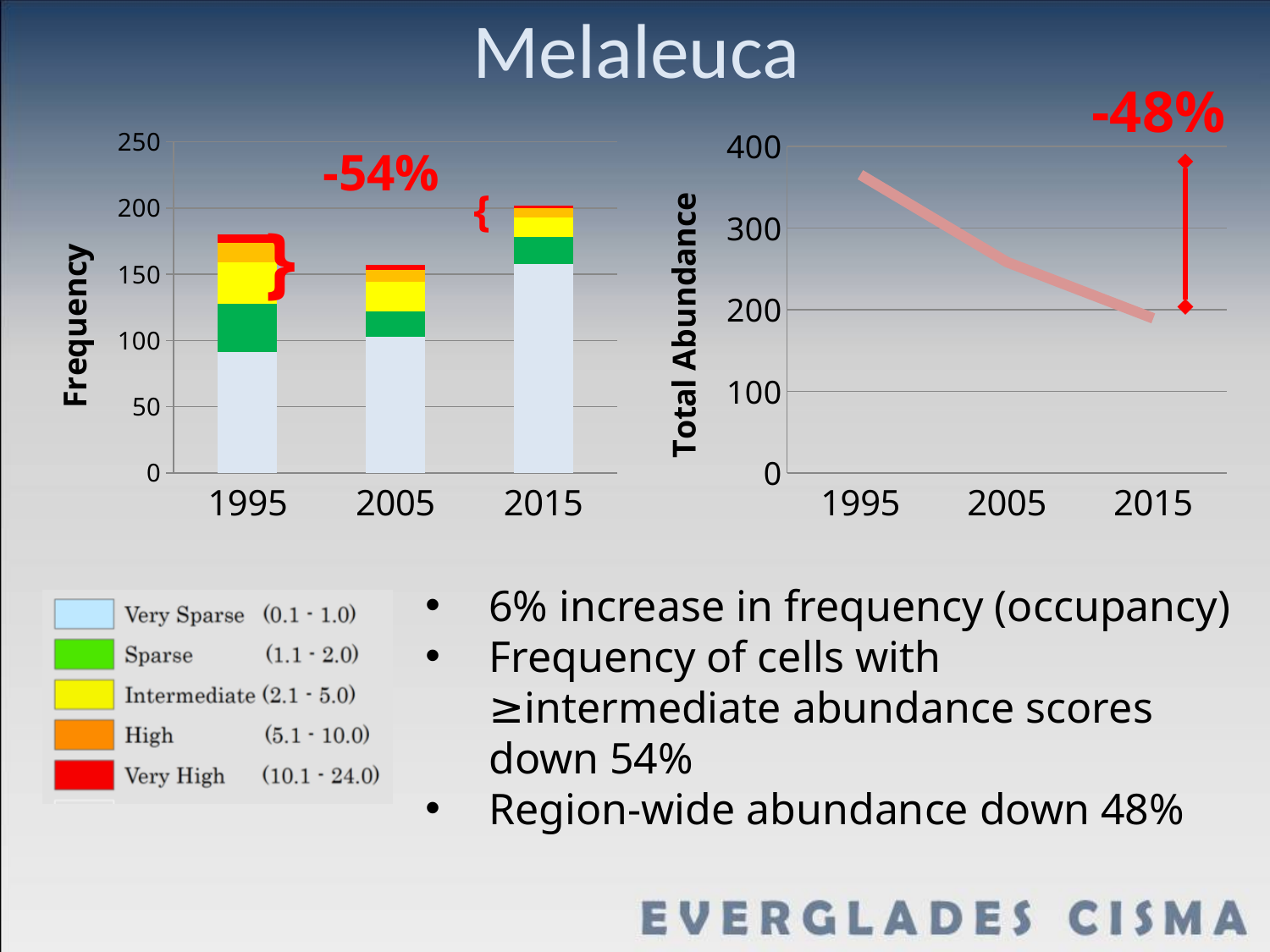
What kind of chart is the right chart with the Total Abundance axis? line chart What percentage change is annotated in red on the right Total Abundance chart? -48% In the right Total Abundance chart, is the value for 2005 greater or less than 300? less In the left Frequency chart, which colour does the legend assign to the Very Sparse class? light blue In the left Frequency chart, is the total bar height for 1995 greater or less than 150? greater In the left Frequency chart, is the total bar height for 2005 greater or less than 200? less In the left Frequency chart, which year has the taller total bar, 1995 or 2005? 1995 In the left Frequency chart, how many years are shown on the x axis? 3 What kind of chart is the left chart with the Frequency axis? stacked bar chart In the right Total Abundance chart, do the values rise or fall from 1995 to 2015? fall In the left Frequency chart, how many abundance classes does the legend list? 5